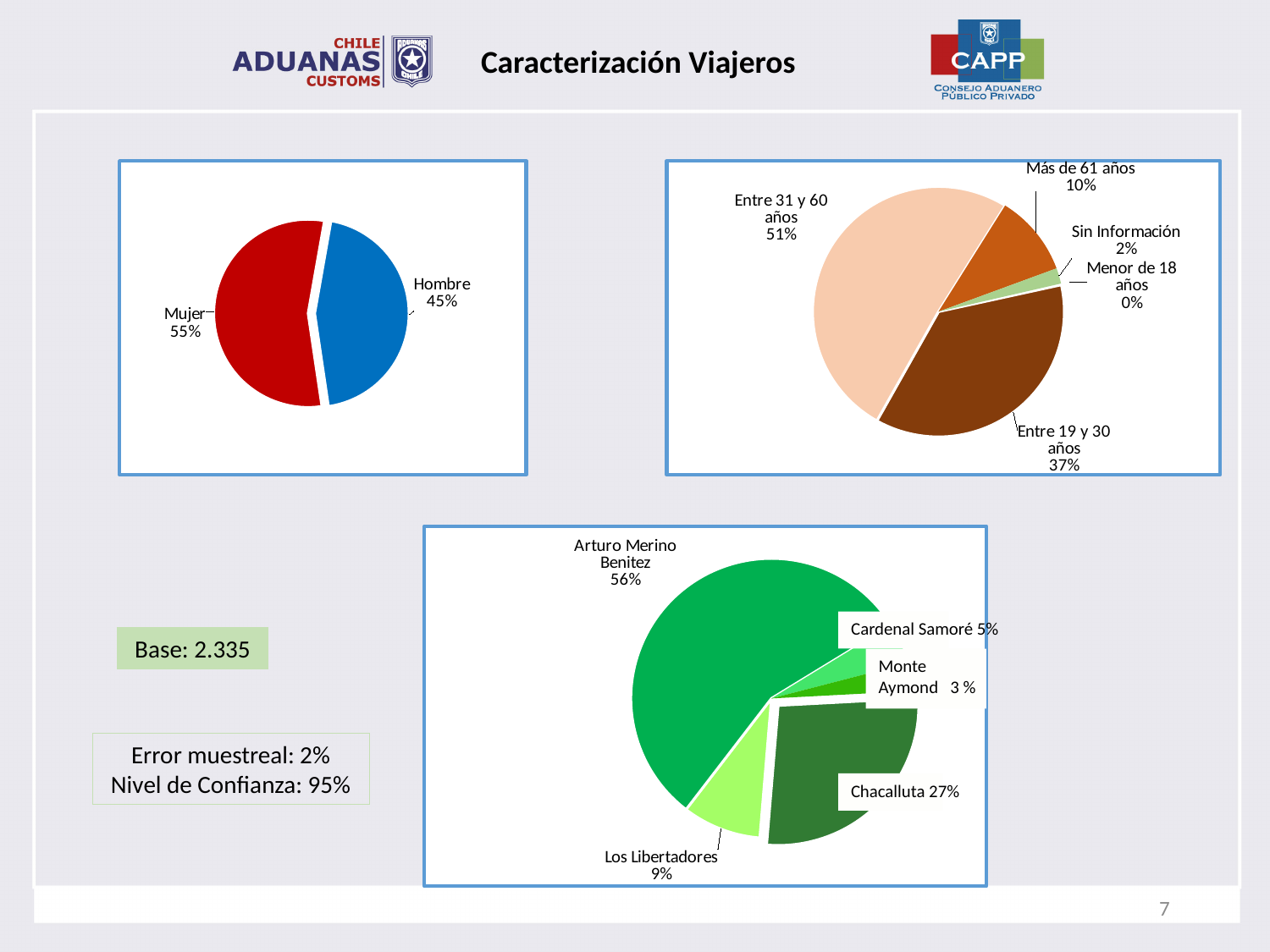
In the top-right pie chart, how many categories are shown? 5 In the top-right pie chart, what share is labelled Entre 19 y 30 años? 37% In the top-right pie chart, which category has the largest slice? Entre 31 y 60 años In the bottom pie chart, what share is labelled Chacalluta? 27% In the top-left pie chart, what share is labelled Mujer? 55% In the top-left pie chart, which slice is larger, Mujer or Hombre? Mujer In the bottom pie chart, which category has the largest slice? Arturo Merino Benitez In the top-right pie chart, which category has the smallest slice? Menor de 18 años What kind of chart is the bottom chart on the slide? Pie chart In the top-right pie chart, what is the difference between the Entre 31 y 60 años share and the Entre 19 y 30 años share? 14%